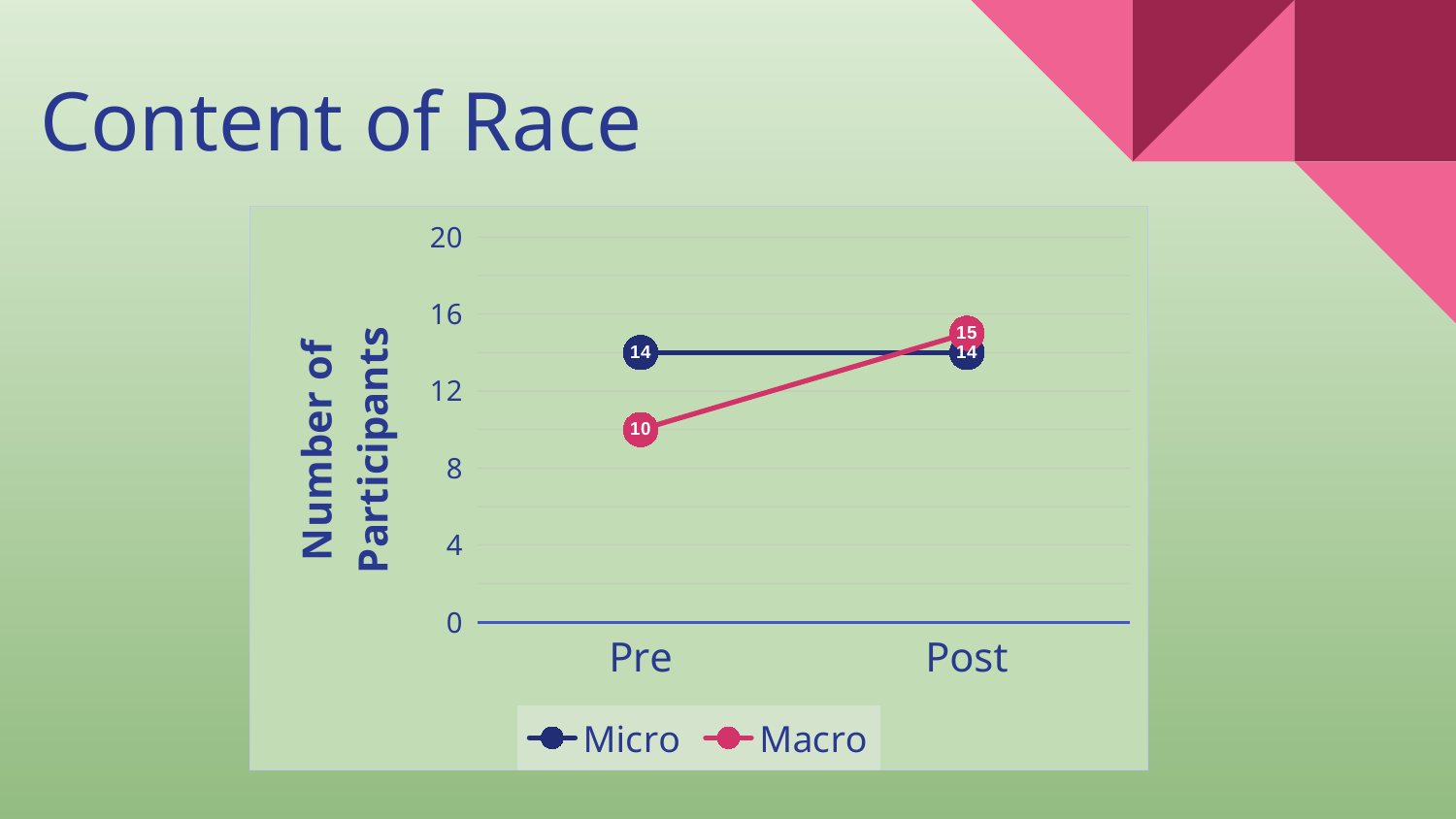
How many series does the legend list? 2 What is the value for Macro at Post? 15 What is the value for Micro at Post? 14 What is the difference between the Macro values at Post and Pre? 5 What is the y-axis label of the chart? Number of Participants What kind of chart is shown on the slide? line chart Does the Macro series rise or fall from Pre to Post? rise Which series is drawn in pink? Macro What is the value for Macro at Pre? 10 What is the value for Micro at Pre? 14 How many categories are shown on the x axis? 2 At Pre, which series has the larger value, Micro or Macro? Micro